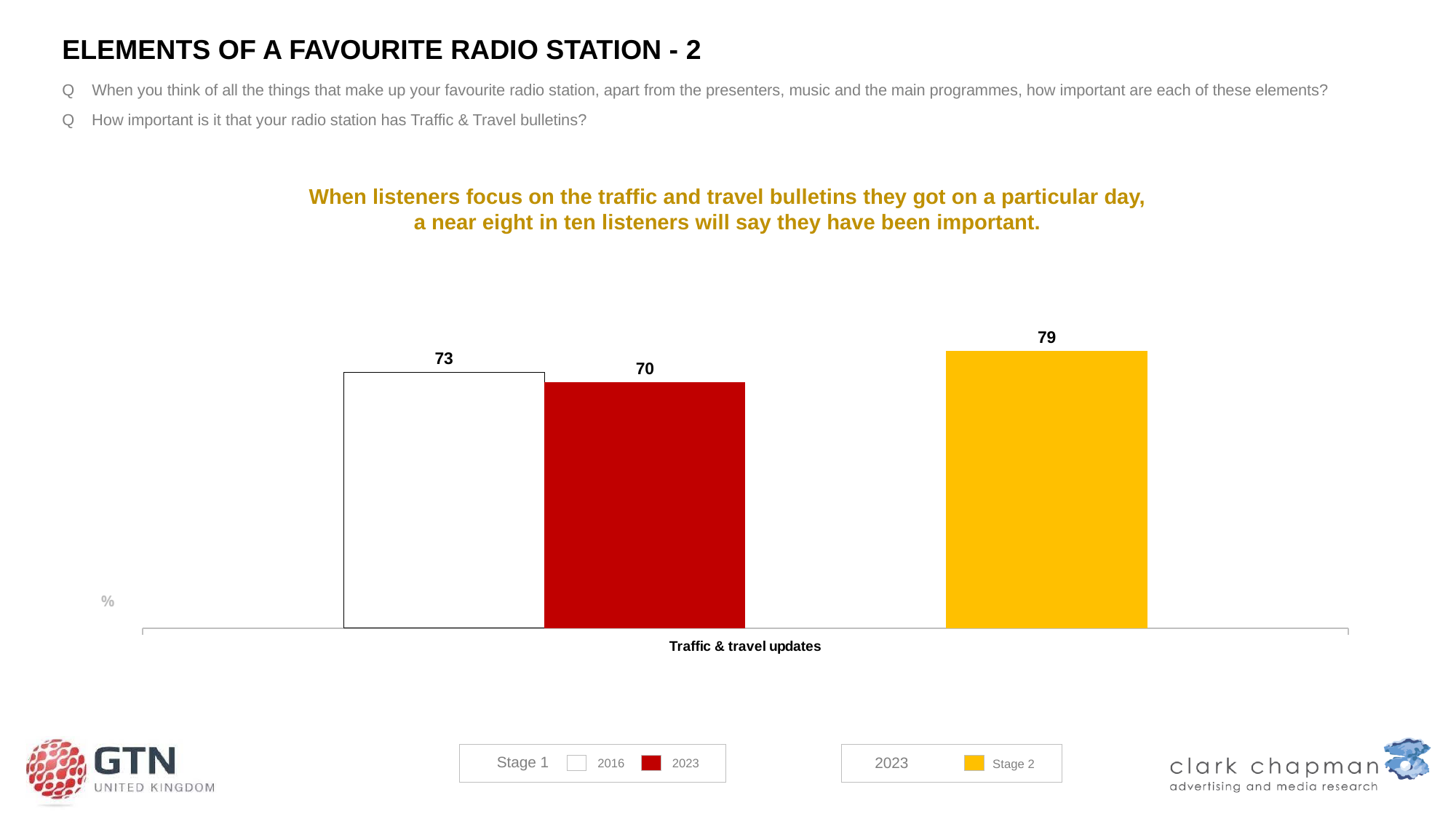
What kind of chart is shown on the slide? Bar chart What is the value of the yellow Stage 2 2023 bar for Traffic & travel updates? 79 Which is larger, the Stage 1 2016 value or the Stage 1 2023 value? Stage 1 2016 What is the value of the red Stage 1 2023 bar for Traffic & travel updates? 70 How many bars are plotted on the chart? 3 What is the difference between the Stage 1 2016 value and the Stage 1 2023 value? 3 What is the value of the white Stage 1 2016 bar for Traffic & travel updates? 73 Which bar has the highest value on the chart? Stage 2 2023 What is the category label shown on the x axis of the chart? Traffic & travel updates Which bar has the lowest value on the chart? Stage 1 2023 What colour is the Stage 2 bar in the chart? Yellow What is the difference between the Stage 2 2023 value and the Stage 1 2023 value? 9